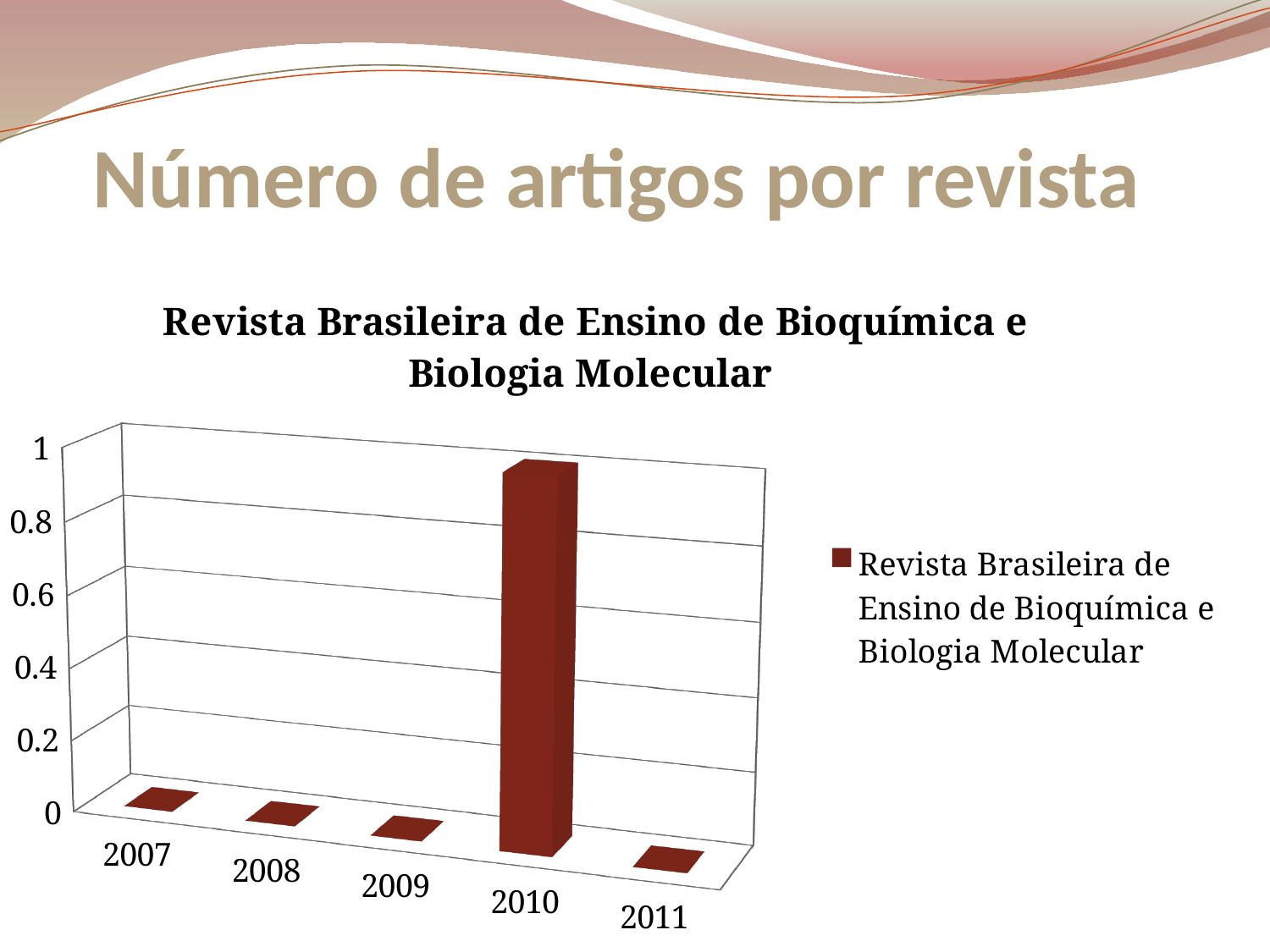
What is the value for 2007? 0 What is the highest value shown on the vertical axis? 1 Which is larger, the value for 2010 or the value for 2009? 2010 Which year has the highest number of articles? 2010 How many years are shown on the x axis of the chart? 5 How many series does the legend list? 1 What is the difference between the values for 2010 and 2008? 1 What is the value for 2010? 1 What is the value for 2011? 0 What kind of chart is shown on the slide? bar chart What is the title of the chart? Revista Brasileira de Ensino de Bioquímica e Biologia Molecular Is the value for 2010 greater or less than 0.6? greater